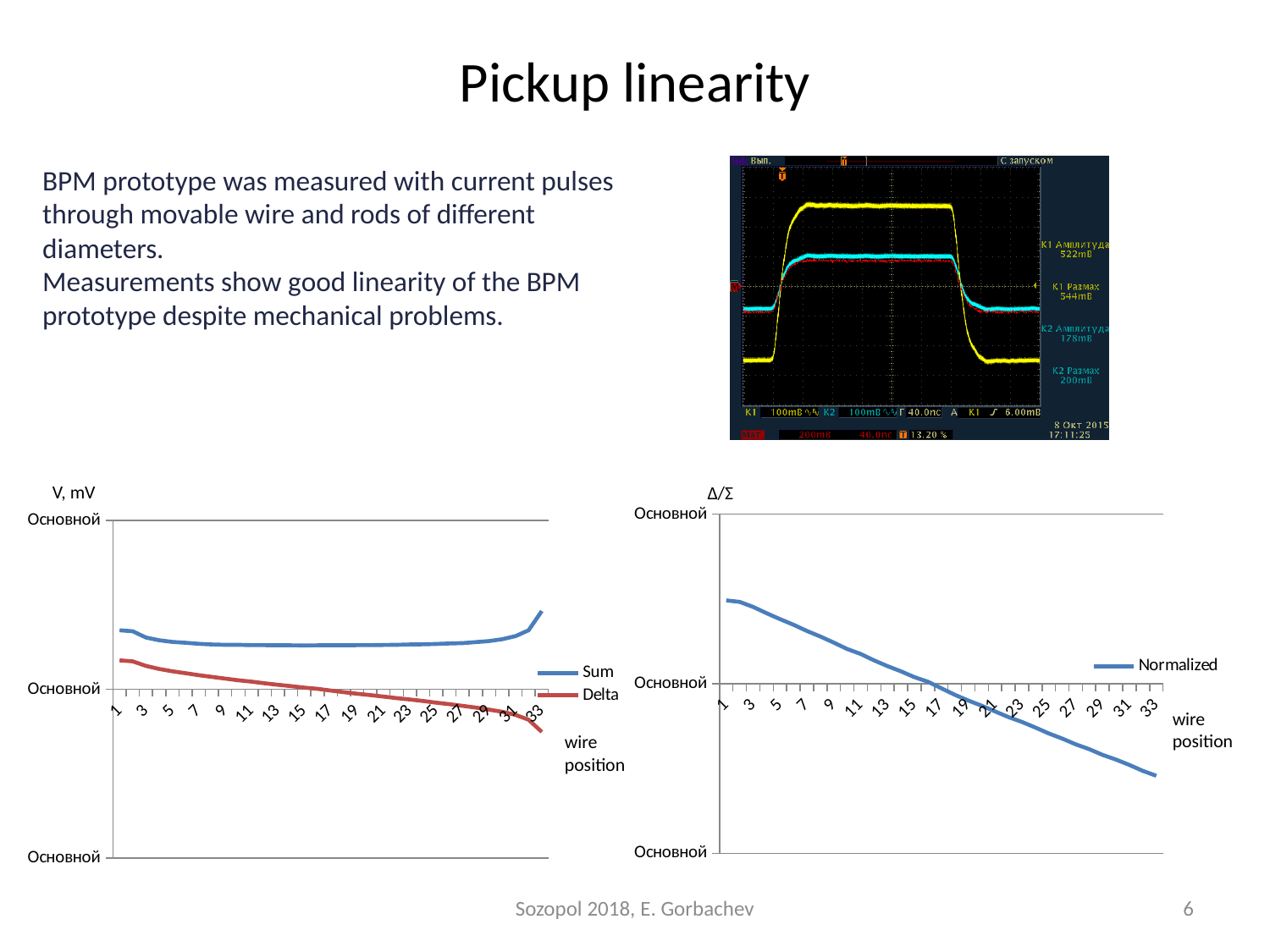
How many series does the legend of the right chart (Δ/Σ) list? 1 In the left chart (V, mV), which series is drawn in red? Delta What kind of chart is the right chart labelled "Δ/Σ"? line chart In the left chart (V, mV), what are the names of the two series in the legend? Sum and Delta What kind of chart is the left chart labelled "V, mV"? line chart How many series does the legend of the left chart (V, mV) list? 2 In the left chart (V, mV), does the Delta series rise or fall as wire position increases? fall In the right chart (Δ/Σ), does the Normalized series rise or fall as wire position increases? fall In the left chart (V, mV), what is the highest wire position label shown on the x axis? 33 In the left chart (V, mV), which series has the larger values, Sum or Delta? Sum